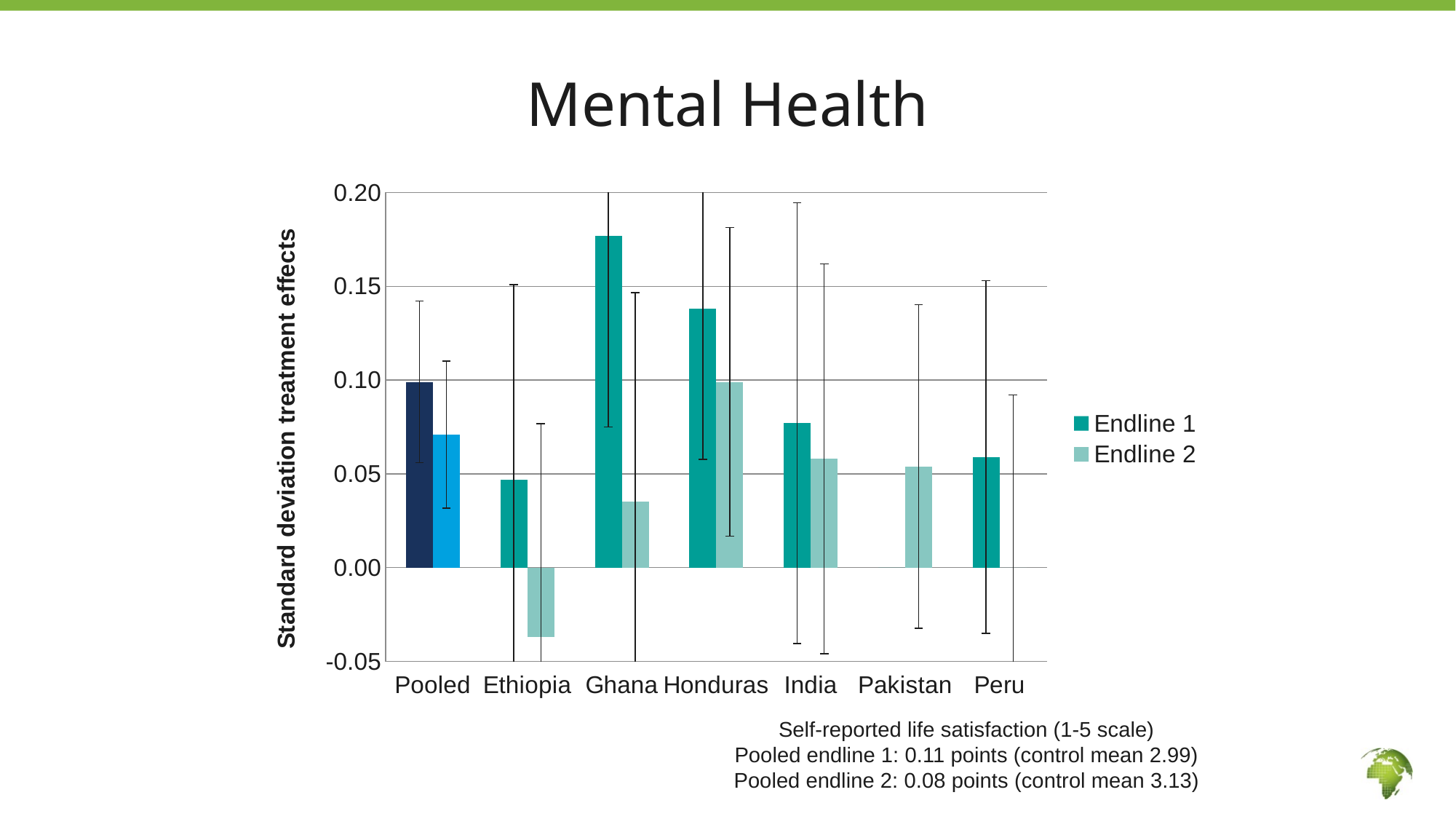
For Ghana, which is larger: the Endline 1 value or the Endline 2 value? Endline 1 What is the title of the y axis? Standard deviation treatment effects Is the Endline 1 value for Ghana greater or less than 0.15? greater What kind of chart is shown on the slide? bar chart Which category has the lowest Endline 2 value? Ethiopia Is the Endline 1 value for India greater or less than 0.05? greater How many categories are shown on the x axis? 7 Which category has the highest Endline 2 value? Honduras Which category has the highest Endline 1 value? Ghana Is the Endline 2 value for Ethiopia greater or less than 0.00? less How many series does the legend list? 2 Which category has no Endline 1 bar? Pakistan